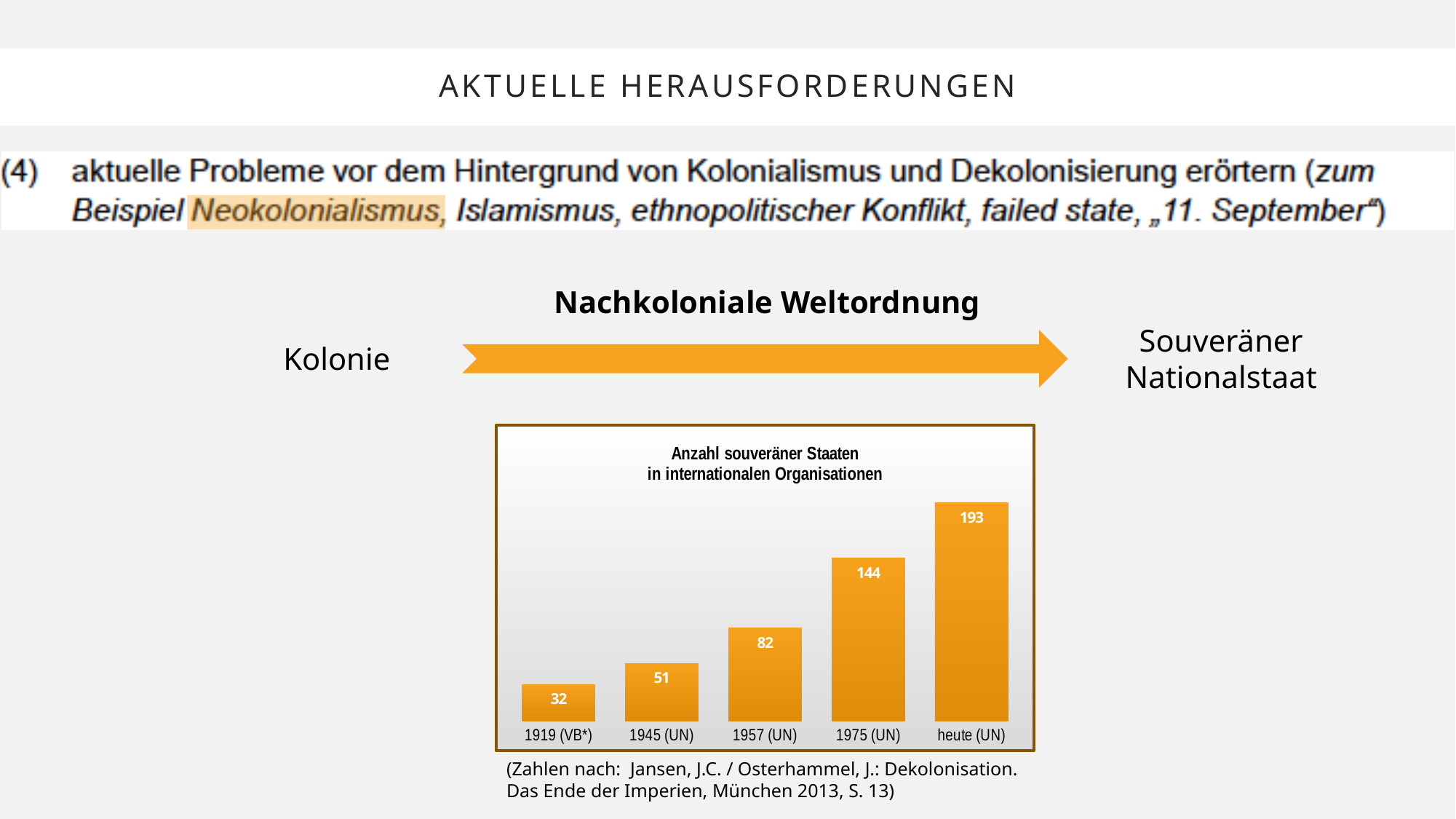
How many categories are shown in the chart? 5 What is the difference between the values for 1975 (UN) and 1945 (UN)? 93 What is the value for heute (UN) in the chart? 193 What kind of chart is shown on the slide? bar chart Which category has the highest value in the chart? heute (UN) What is the value for 1919 (VB*) in the chart? 32 Which category has the lowest value in the chart? 1919 (VB*) What is the title of the chart? Anzahl souveräner Staaten in internationalen Organisationen Do the values rise or fall from left to right along the x axis? rise Which is larger, the value for 1957 (UN) or the value for 1945 (UN)? 1957 (UN) What is the value for 1957 (UN) in the chart? 82 What is the difference between the values for heute (UN) and 1919 (VB*)? 161